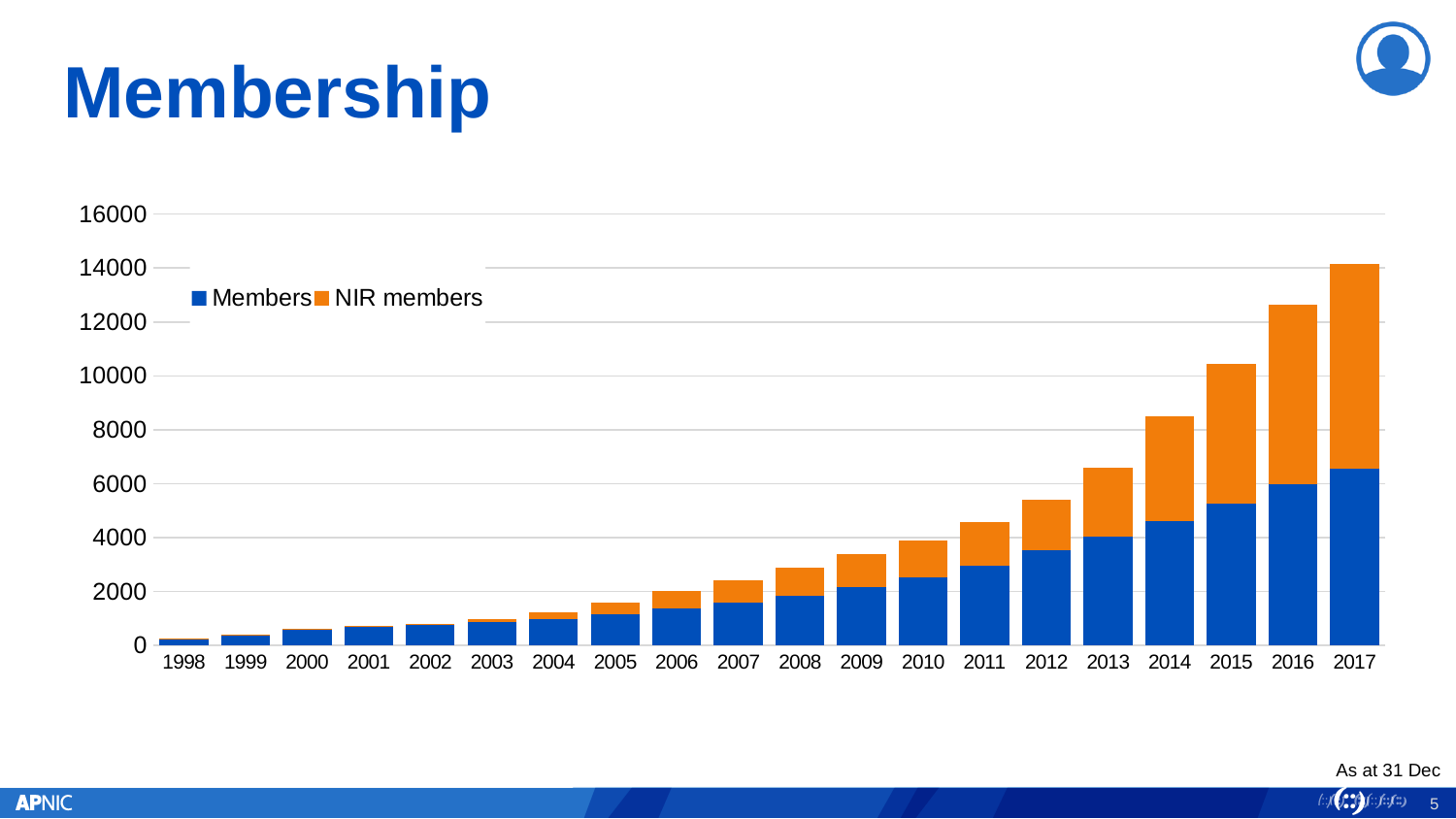
Is the value for Members in 2017 greater or less than 6000? greater How many years are shown along the x axis? 20 Which is larger, the total membership in 2017 or in 2016? 2017 Is the total membership for 2009 greater or less than 4000? less Which colour represents NIR members in the chart? Orange Which year has the highest total membership? 2017 Which year has the lowest total membership? 1998 Do total membership values rise or fall from 1998 to 2017? Rise Is the total membership for 2016 greater or less than 12000? greater How many series does the legend list? 2 What kind of chart is shown on the slide? Stacked bar chart